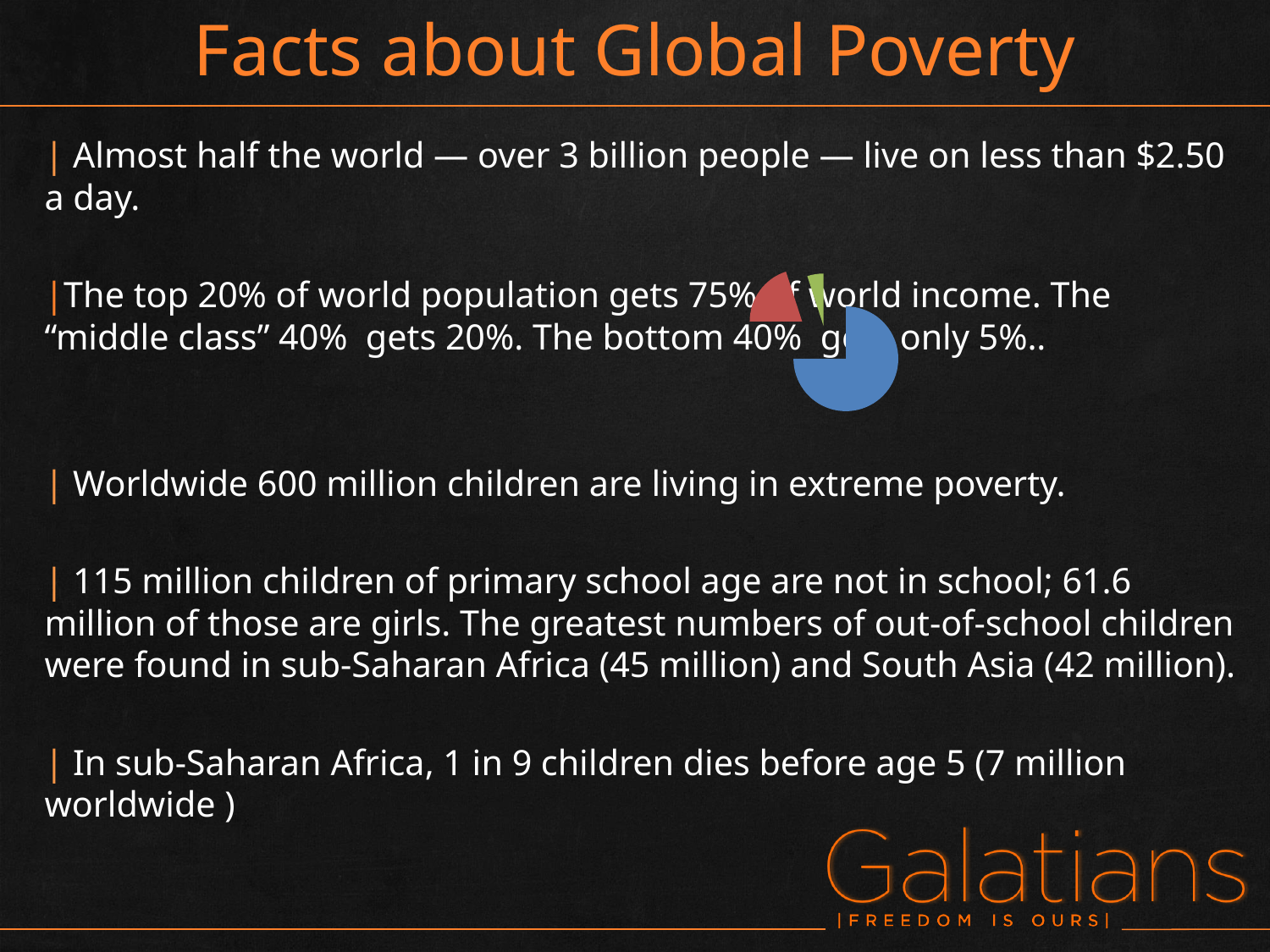
Does the pie chart have a legend? No Which slice of the pie chart is the largest? the blue slice How many slices does the pie chart have? 3 What colours are the slices of the pie chart? blue, red and green In the pie chart, which is larger, the blue slice or the red slice? the blue slice Which slice of the pie chart is the smallest? the green slice What kind of chart is shown on the slide? pie chart In the pie chart, which is larger, the red slice or the green slice? the red slice